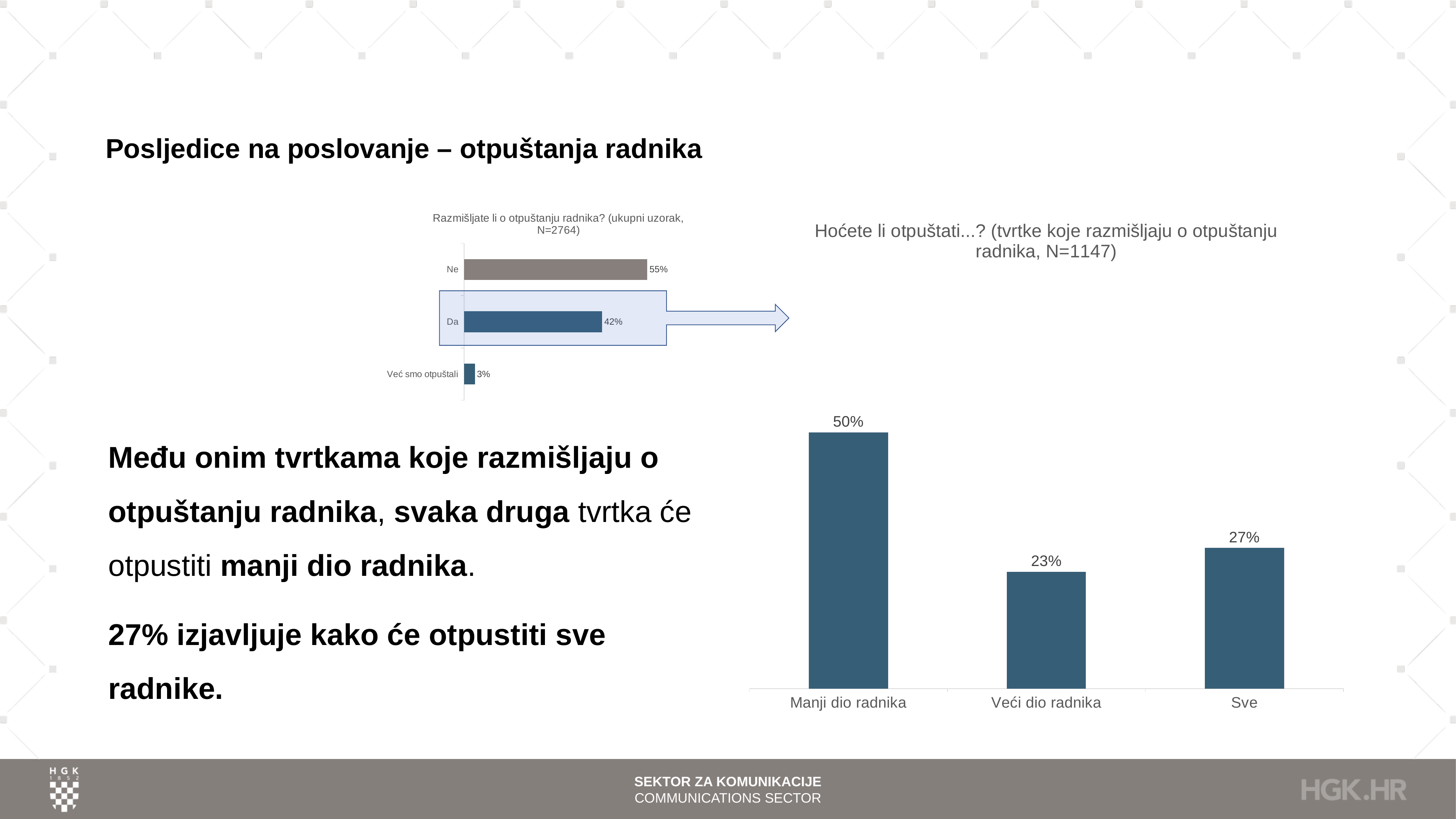
In the chart titled "Razmišljate li o otpuštanju radnika?", how many categories are shown? 3 In the chart titled "Razmišljate li o otpuštanju radnika?", which category has the highest value? Ne In the chart titled "Razmišljate li o otpuštanju radnika?", which category has the lowest value? Već smo otpuštali In the chart titled "Hoćete li otpuštati...?", which category has the lowest value? Veći dio radnika In the chart titled "Hoćete li otpuštati...?", what is the value for "Manji dio radnika"? 50% What kind of chart is the chart titled "Hoćete li otpuštati...?"? Bar chart In the chart titled "Razmišljate li o otpuštanju radnika?", what is the value for "Već smo otpuštali"? 3% In the chart titled "Hoćete li otpuštati...?", what is the value for "Veći dio radnika"? 23% In the chart titled "Razmišljate li o otpuštanju radnika?", what is the value for "Ne"? 55% In the chart titled "Hoćete li otpuštati...?", which is larger, the value for "Sve" or the value for "Veći dio radnika"? Sve In the chart titled "Razmišljate li o otpuštanju radnika?", what is the difference between the values for "Ne" and "Da"? 13% In the chart titled "Razmišljate li o otpuštanju radnika?", what is the value for "Da"? 42%